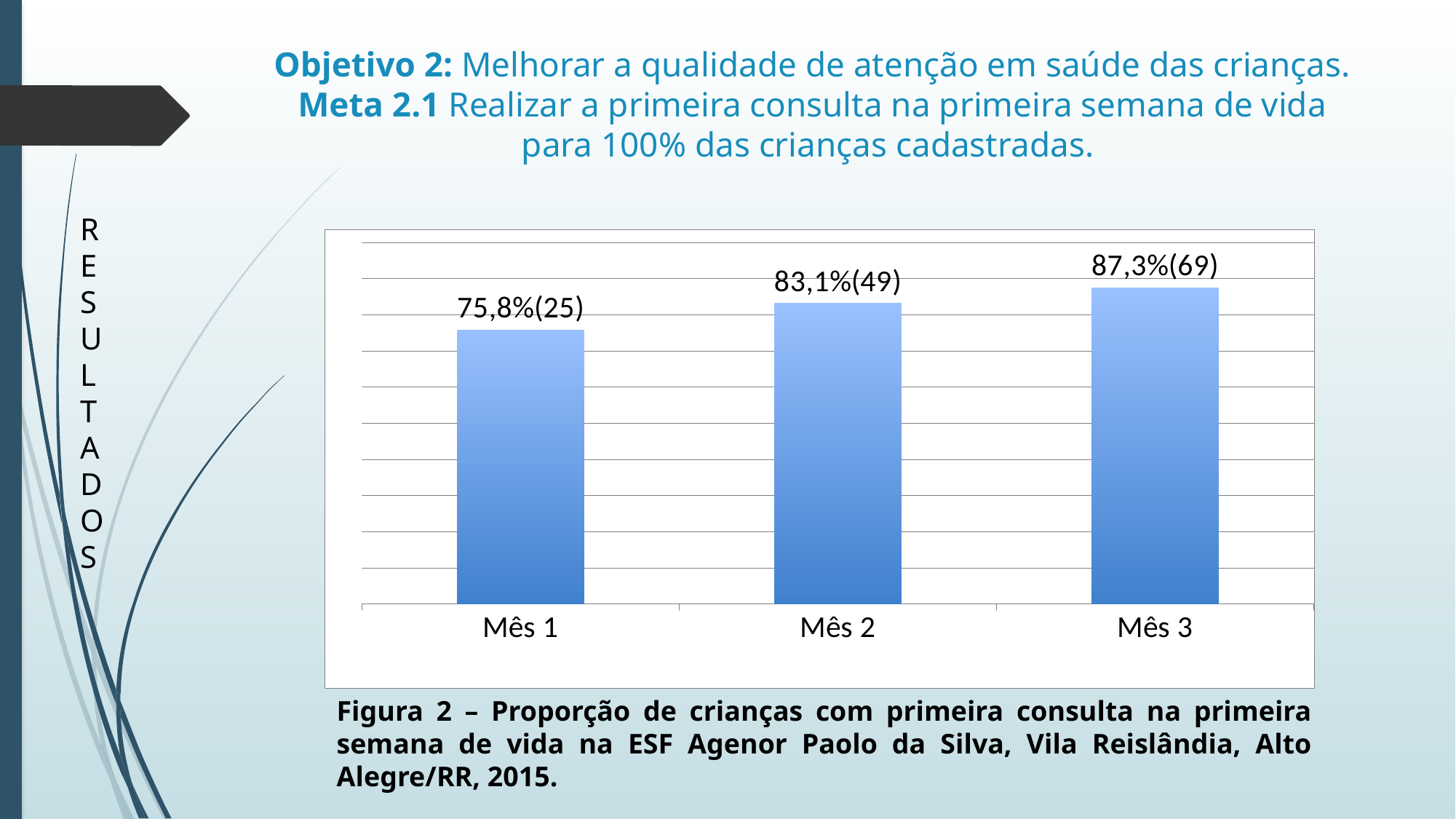
Do the values rise or fall from Mês 1 to Mês 3? Rise What is the data label shown for Mês 1? 75,8%(25) What is the data label shown for Mês 3? 87,3%(69) Which month has the lowest proportion? Mês 1 Which month has the highest proportion? Mês 3 How many months (categories) are shown on the x axis? 3 What is the difference in percentage points between Mês 2 and Mês 1? 7,3 Which is larger, the value for Mês 2 or the value for Mês 3? Mês 3 What is the difference in percentage points between Mês 3 and Mês 1? 11,5 What percentage is shown for Mês 2? 83,1% How many children are shown in parentheses for Mês 2? 49 What kind of chart is shown on the slide? Bar chart